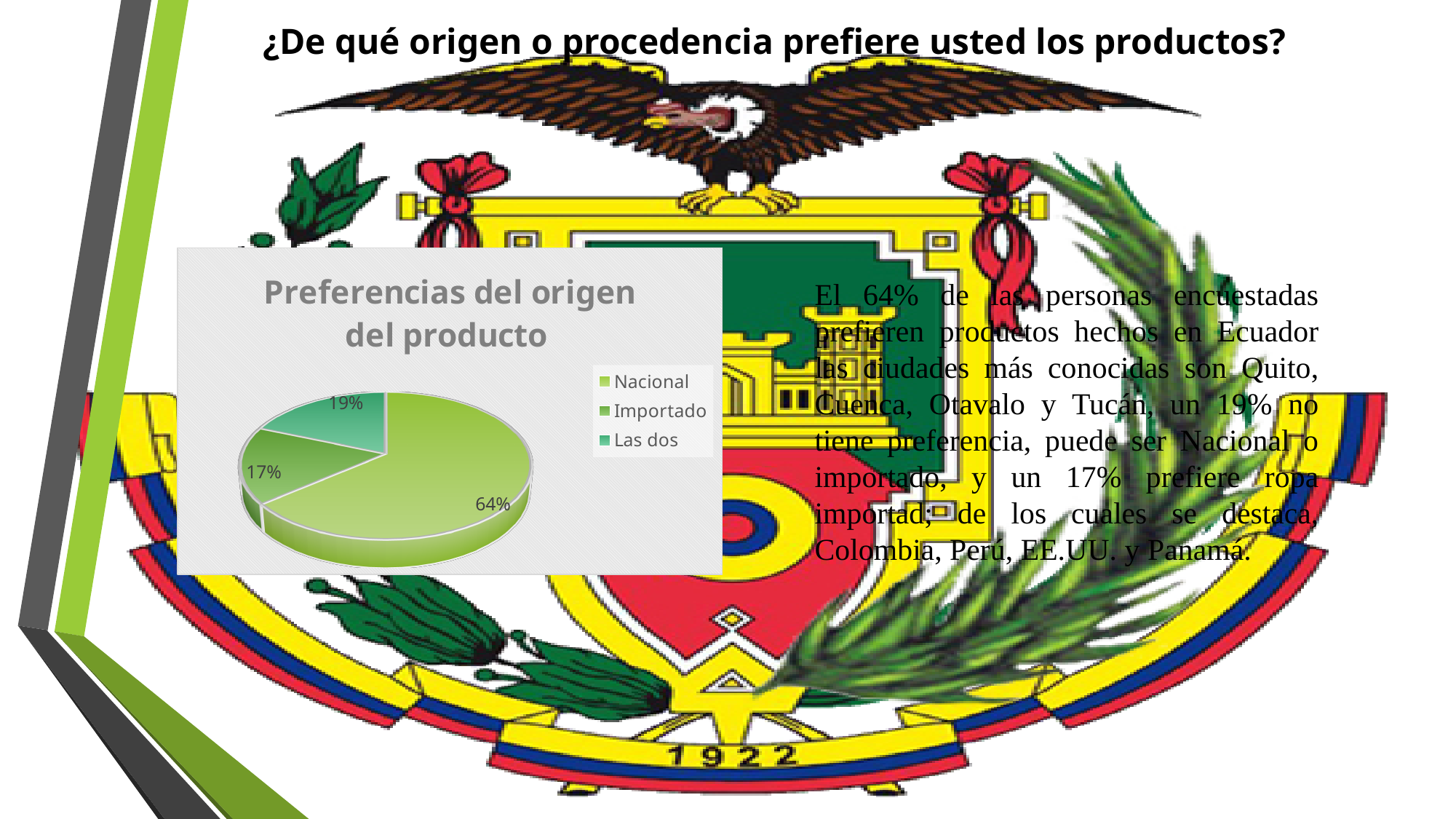
What is the title of the chart? Preferencias del origen del producto What percentage of the pie corresponds to Importado? 17% Which category has the largest share of the pie? Nacional What type of chart is shown on the slide? pie chart What percentage of the pie corresponds to Nacional? 64% Which legend entry is listed first in the chart legend? Nacional Which category has the smallest share of the pie? Importado What is the difference in percentage points between Nacional and Las dos? 45 Which is larger, the share for Las dos or the share for Importado? Las dos How many entries does the chart legend list? 3 What percentage of the pie corresponds to Las dos? 19% How many slices does the pie chart have? 3